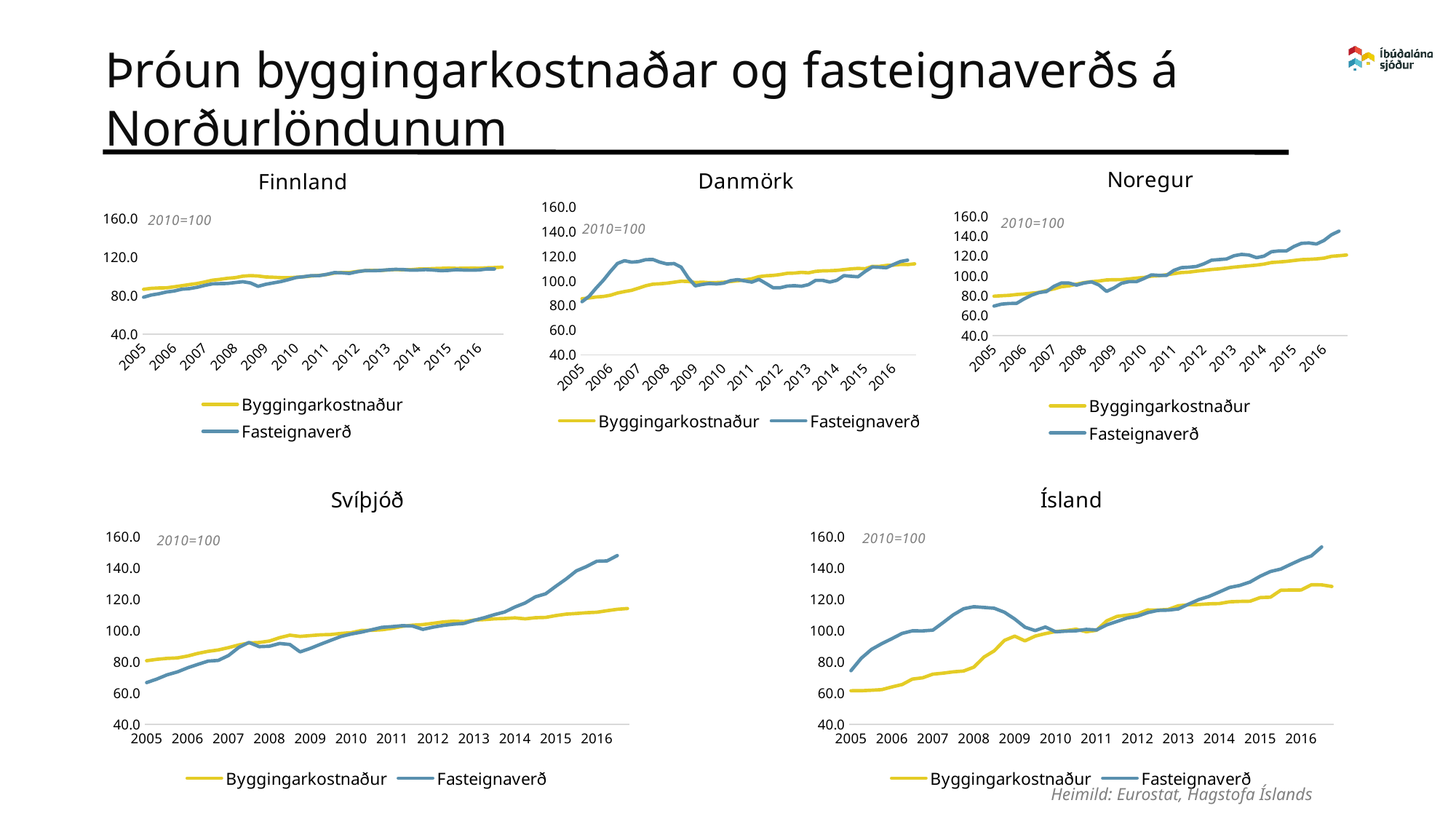
In the Ísland chart, is the value of Fasteignaverð at the end of 2016 greater or less than 140? greater In the Noregur chart, does Byggingarkostnaður rise or fall from 2005 to 2016? rise In the Ísland chart, which series is higher at the end of 2016, Byggingarkostnaður or Fasteignaverð? Fasteignaverð How many series does the legend of the Ísland chart list? 2 In the Svíþjóð chart, does Fasteignaverð rise or fall from 2013 to 2016? rise What kind of chart is the Finnland chart? line chart What base-year note is printed on each chart? 2010=100 How many year labels are shown on the x axis of the Svíþjóð chart? 12 In the Svíþjóð chart, is the value of Fasteignaverð at the start of 2005 greater or less than 80? less In the Noregur chart, is the value of Fasteignaverð at the end of 2016 greater or less than 120? greater